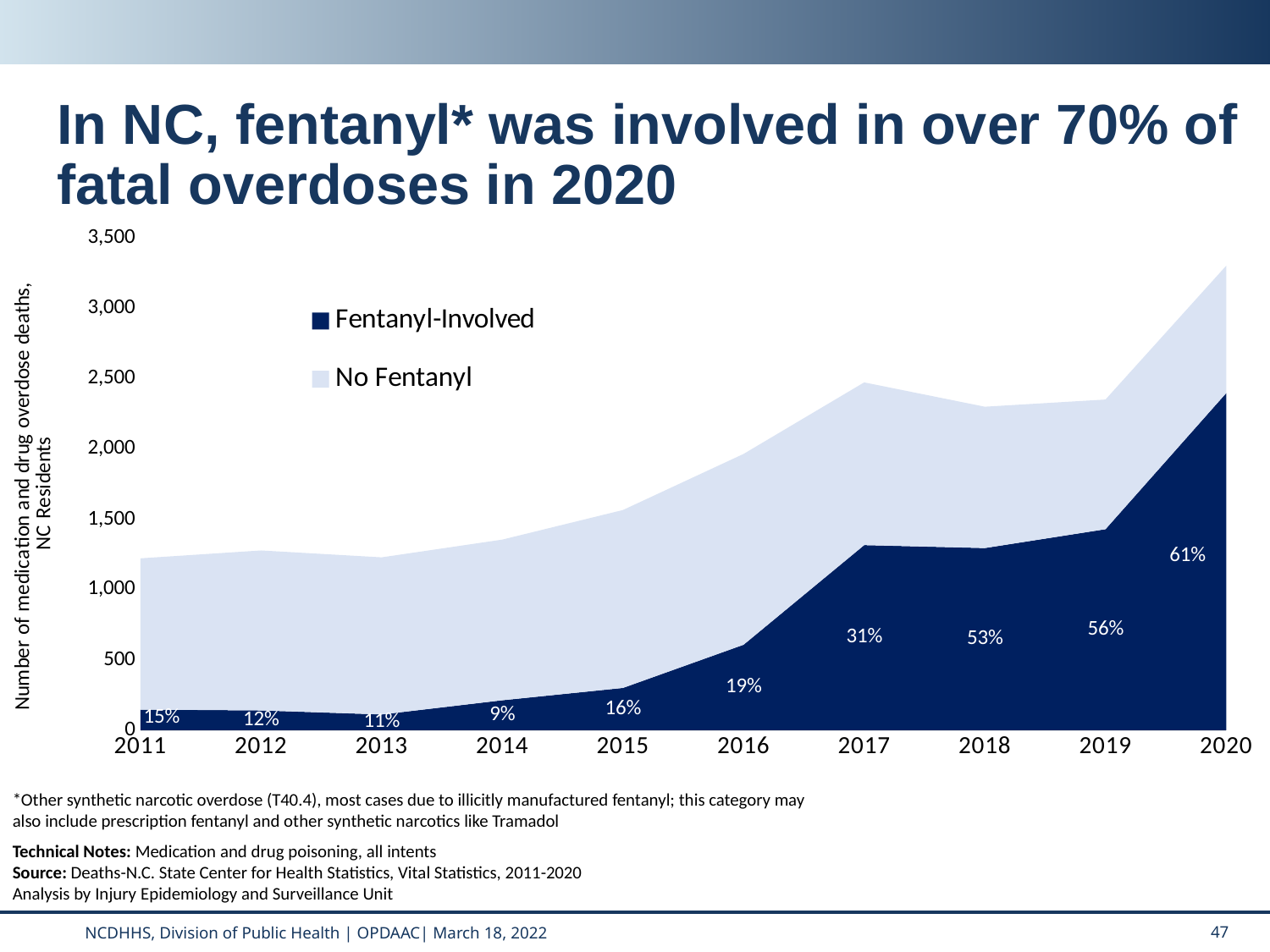
What percentage of fatal overdoses were fentanyl-involved in 2018? 53% How many series does the legend list? 2 What percentage label is shown for 2014? 9% What kind of chart is shown on the slide? Stacked area chart What percentage label is shown for 2016? 19% Is the total number of overdose deaths in 2011 greater or less than 1,500? less How many years are shown on the x axis? 10 Is the total number of overdose deaths in 2020 greater or less than 3,000? greater Which year has the highest fentanyl-involved percentage label? 2020 By how many percentage points did the fentanyl-involved share change from 2018 to 2019? 3 percentage points Which year has a larger fentanyl-involved percentage, 2016 or 2017? 2017 Which year has the lowest fentanyl-involved percentage label? 2014